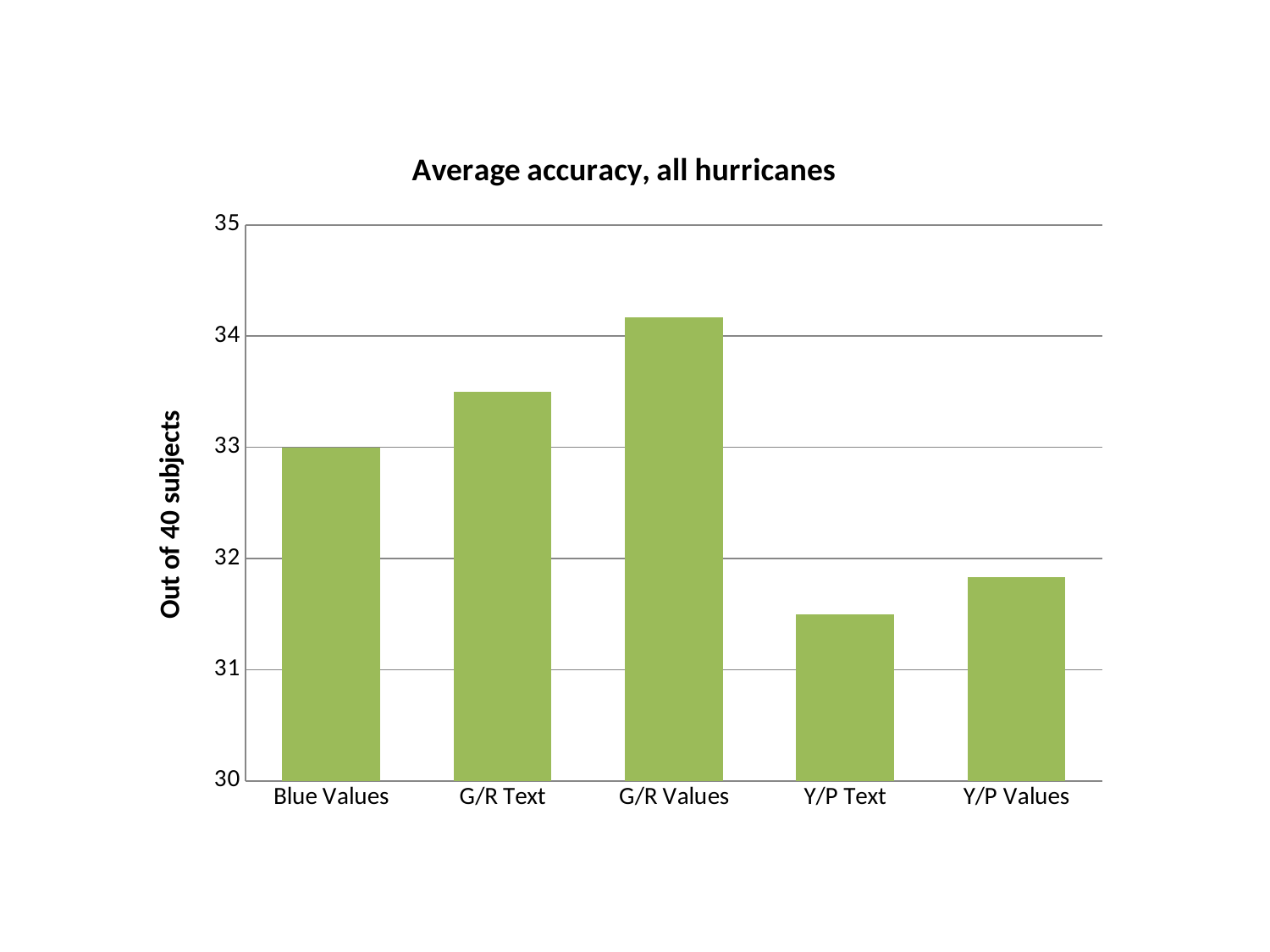
What is the label on the vertical axis of the chart? Out of 40 subjects Is the value for G/R Values greater or less than 34? greater Which is larger, the value for G/R Text or the value for Y/P Values? G/R Text Which category has the lowest value in the chart? Y/P Text What kind of chart is shown on the slide? bar chart How many categories are shown on the x axis of the chart? 5 Is the value for Y/P Text greater or less than 32? less What is the title of the chart? Average accuracy, all hurricanes Which category has the highest value in the chart? G/R Values What is the value for Blue Values? 33 Is the value for Y/P Values greater or less than 32? less